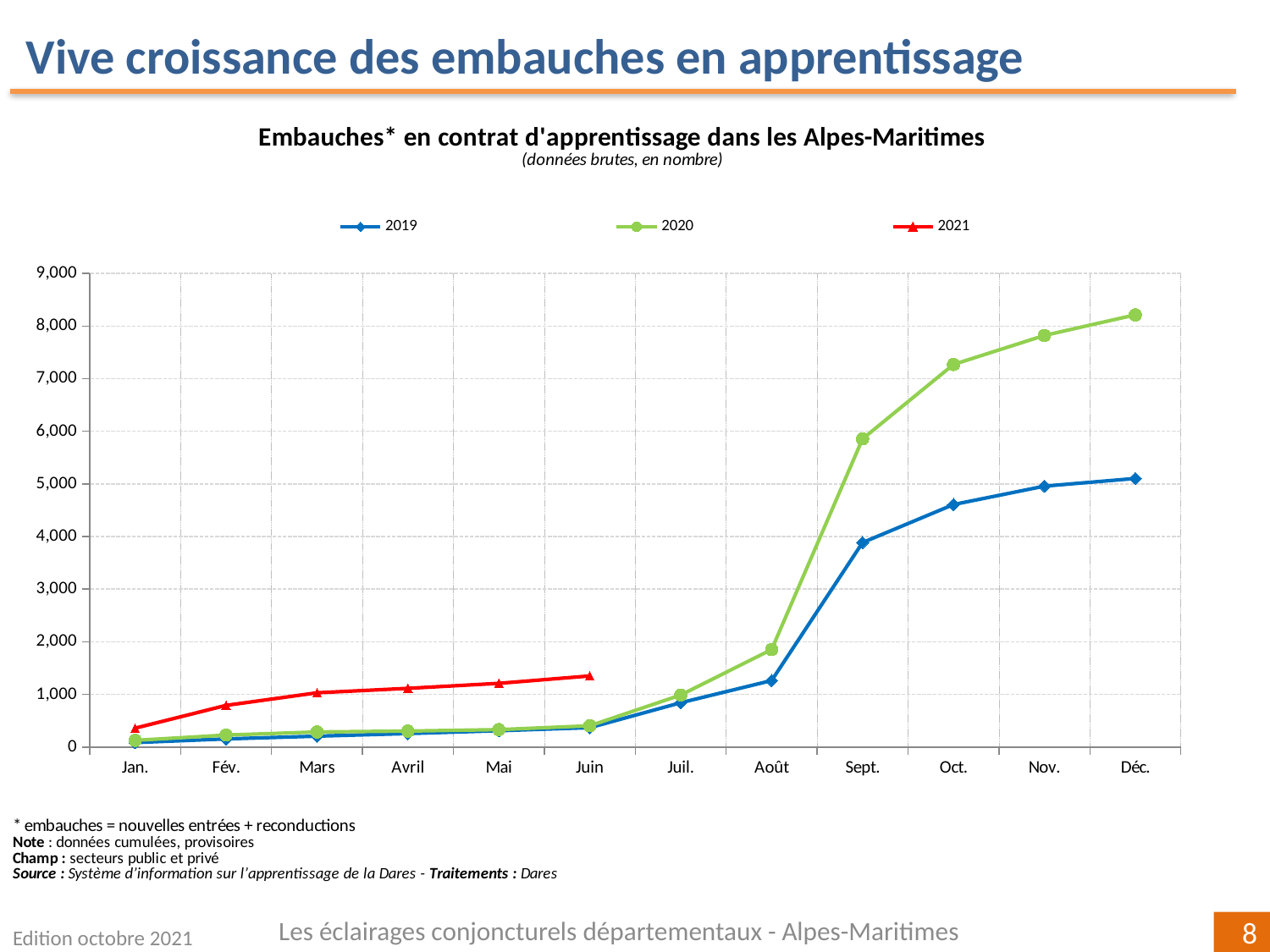
Is the value for 2020 in Déc. greater or less than 8,000? greater Is the value for 2019 in Oct. greater or less than 5,000? less Do the values of the 2020 series rise or fall from Jan. to Déc.? rise Is the value for 2020 in Oct. greater or less than 7,000? greater What is the last month for which the 2021 series has a data point? Juin How many series does the legend list? 3 Which series has the higher value in Mars, 2020 or 2021? 2021 What kind of chart is shown on the slide? line chart Which series has the higher value in Déc., 2019 or 2020? 2020 In which month does the 2020 series reach its highest value? Déc. How many months are shown on the x axis? 12